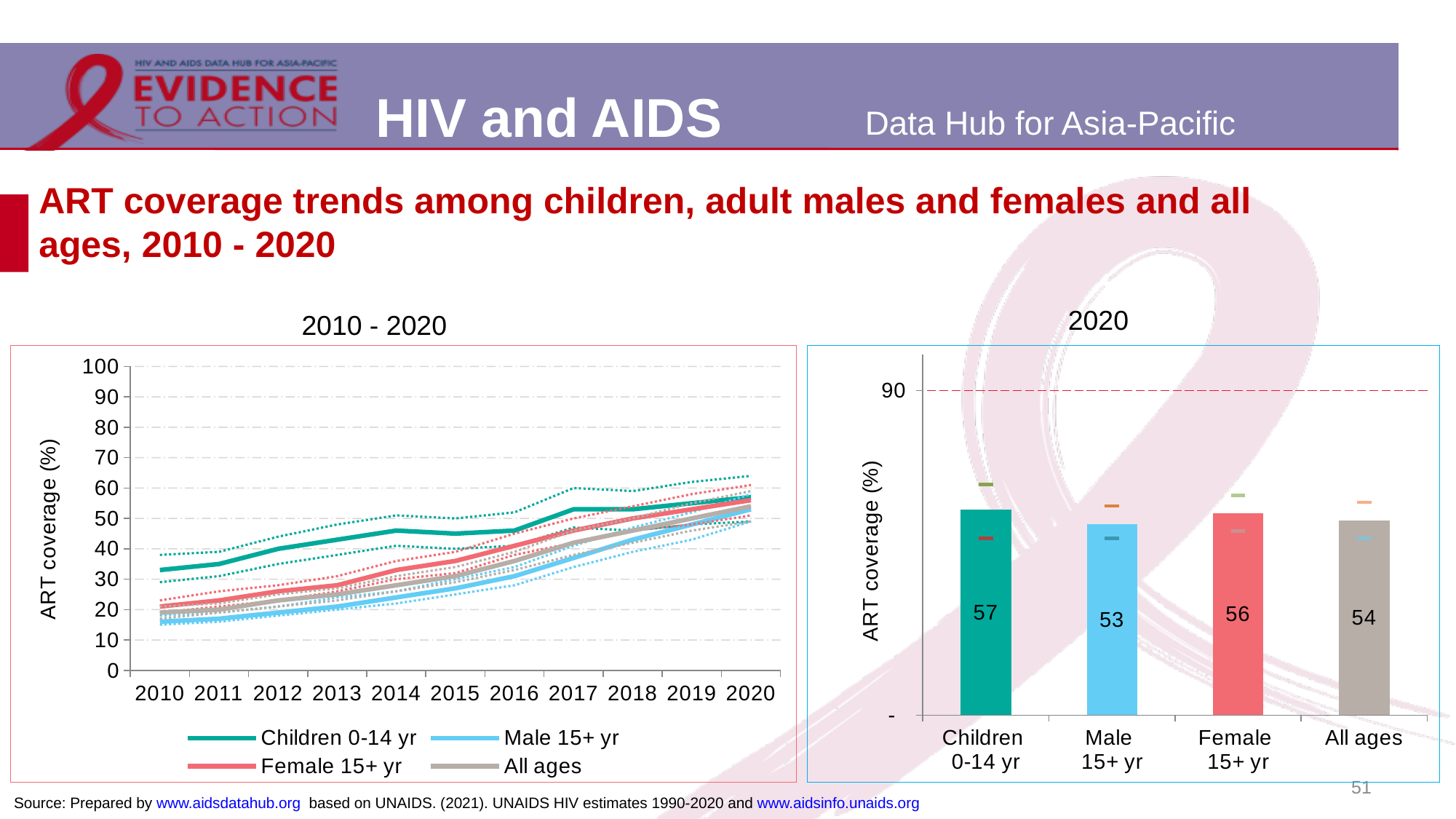
How many series does the legend of the 2010 - 2020 chart list? 4 In the 2020 bar chart, what is the difference between the ART coverage for Female 15+ yr and Male 15+ yr? 3 In the 2020 bar chart, which group has the lowest ART coverage? Male 15+ yr In the 2020 bar chart, what is the ART coverage for Children 0-14 yr? 57 In the 2020 bar chart, what value does the dashed horizontal line mark? 90 In the 2020 bar chart, how many groups are shown? 4 In the 2010 - 2020 chart, is the ART coverage for Children 0-14 yr in 2010 greater or less than 30? greater In the 2010 - 2020 chart, does ART coverage for Male 15+ yr rise or fall from 2010 to 2020? Rise What kind of chart is the 2010 - 2020 chart on the left? Line chart In the 2020 bar chart, which group has the highest ART coverage? Children 0-14 yr In the 2020 bar chart, what is the ART coverage for All ages? 54 In the 2020 bar chart, what is the ART coverage for Male 15+ yr? 53